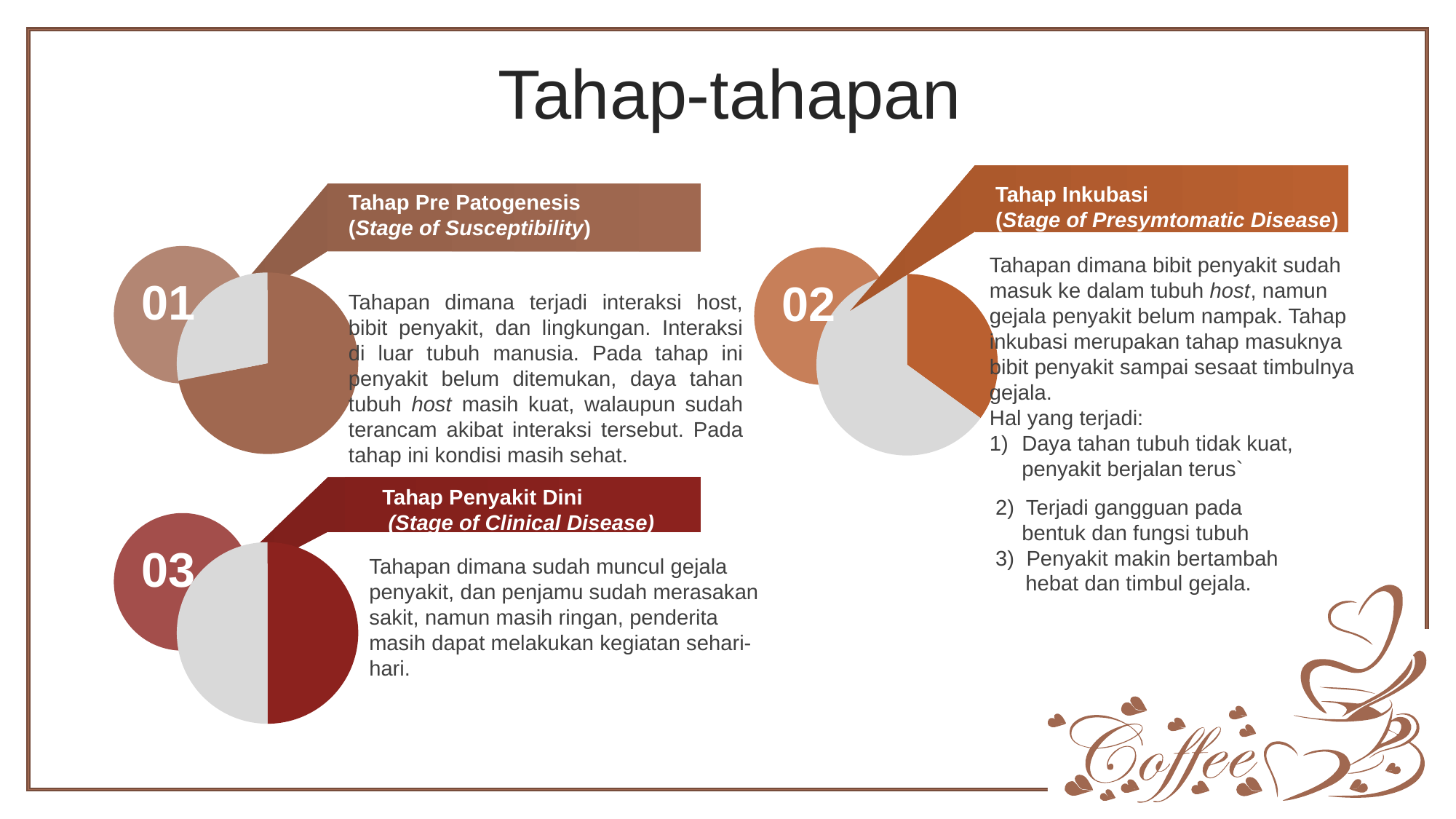
In the pie chart next to 02, how many slices are there? 2 In the pie chart next to 03, how many slices are there? 2 What kind of chart is shown next to the number 01? pie chart In the pie chart next to 02, is the orange slice's share greater or less than 50%? less How many pie charts are on the slide? 3 Which stage label is placed above the pie chart next to 03? Tahap Penyakit Dini (Stage of Clinical Disease) What kind of chart is shown next to the number 03? pie chart In the pie chart next to 01, which slice is larger, the brown slice or the grey slice? the brown slice What kind of chart is shown next to the number 02? pie chart In the pie chart next to 01, is the brown slice's share greater or less than 50%? greater In the pie chart next to 02, which slice is larger, the orange slice or the grey slice? the grey slice